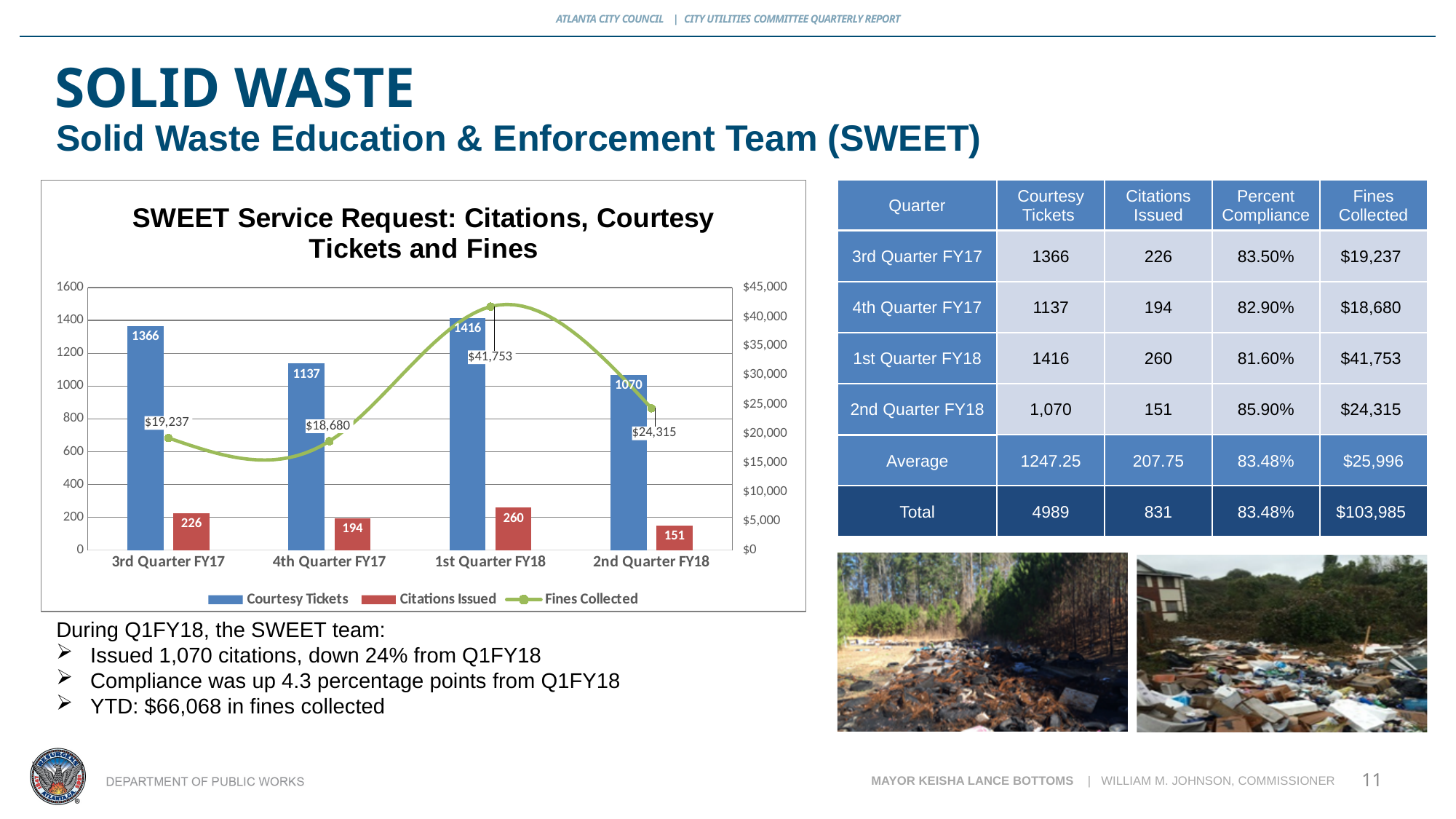
Which quarter has the lowest number of Citations Issued? 2nd Quarter FY18 Is the Courtesy Tickets value for 2nd Quarter FY18 greater or less than 1200? less What kind of chart is used to show Courtesy Tickets and Citations Issued? Bar chart What is the Fines Collected value for 2nd Quarter FY18? $24,315 Which is larger, Citations Issued in 3rd Quarter FY17 or in 1st Quarter FY18? 1st Quarter FY18 What is the difference in Courtesy Tickets between 3rd Quarter FY17 and 4th Quarter FY17? 229 How many Citations Issued are shown for 4th Quarter FY17? 194 How many series does the chart legend list? 3 How many quarters are shown on the x axis of the chart? 4 Which quarter has the highest Fines Collected? 1st Quarter FY18 What is the value for Courtesy Tickets in 1st Quarter FY18? 1416 What is the title of the chart? SWEET Service Request: Citations, Courtesy Tickets and Fines